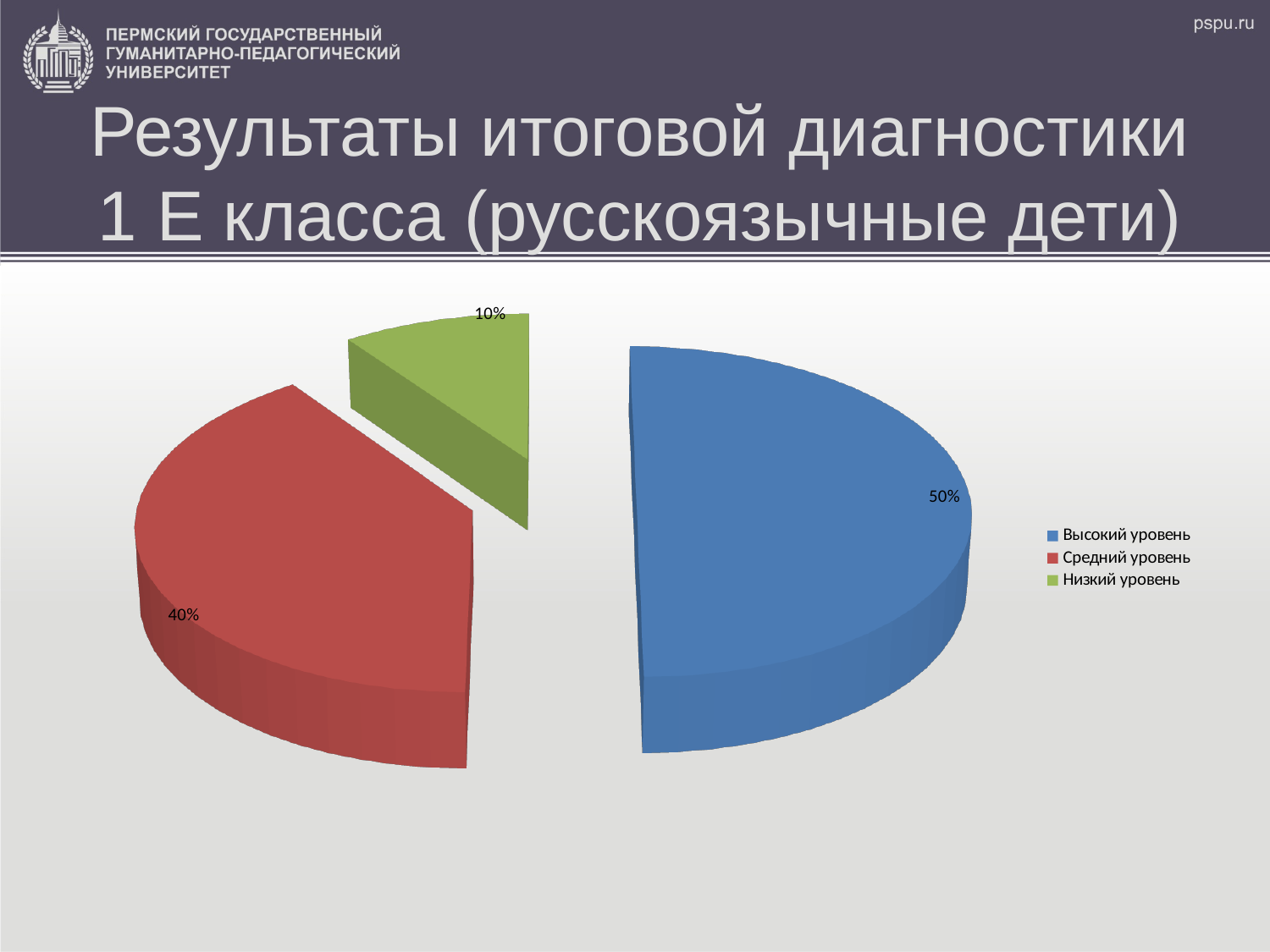
What colour is the slice for Низкий уровень? green What kind of chart is shown on the slide? pie chart How many slices does the pie chart have? 3 Which category has the smallest slice of the pie? Низкий уровень What share of the pie does Средний уровень have? 40% Which is larger, the share of Средний уровень or the share of Низкий уровень? Средний уровень What is the difference between the shares of Средний уровень and Низкий уровень? 30% What share of the pie does Высокий уровень have? 50% Which category has the largest slice of the pie? Высокий уровень What share of the pie does Низкий уровень have? 10% How many entries does the legend list? 3 What is the difference between the shares of Высокий уровень and Средний уровень? 10%